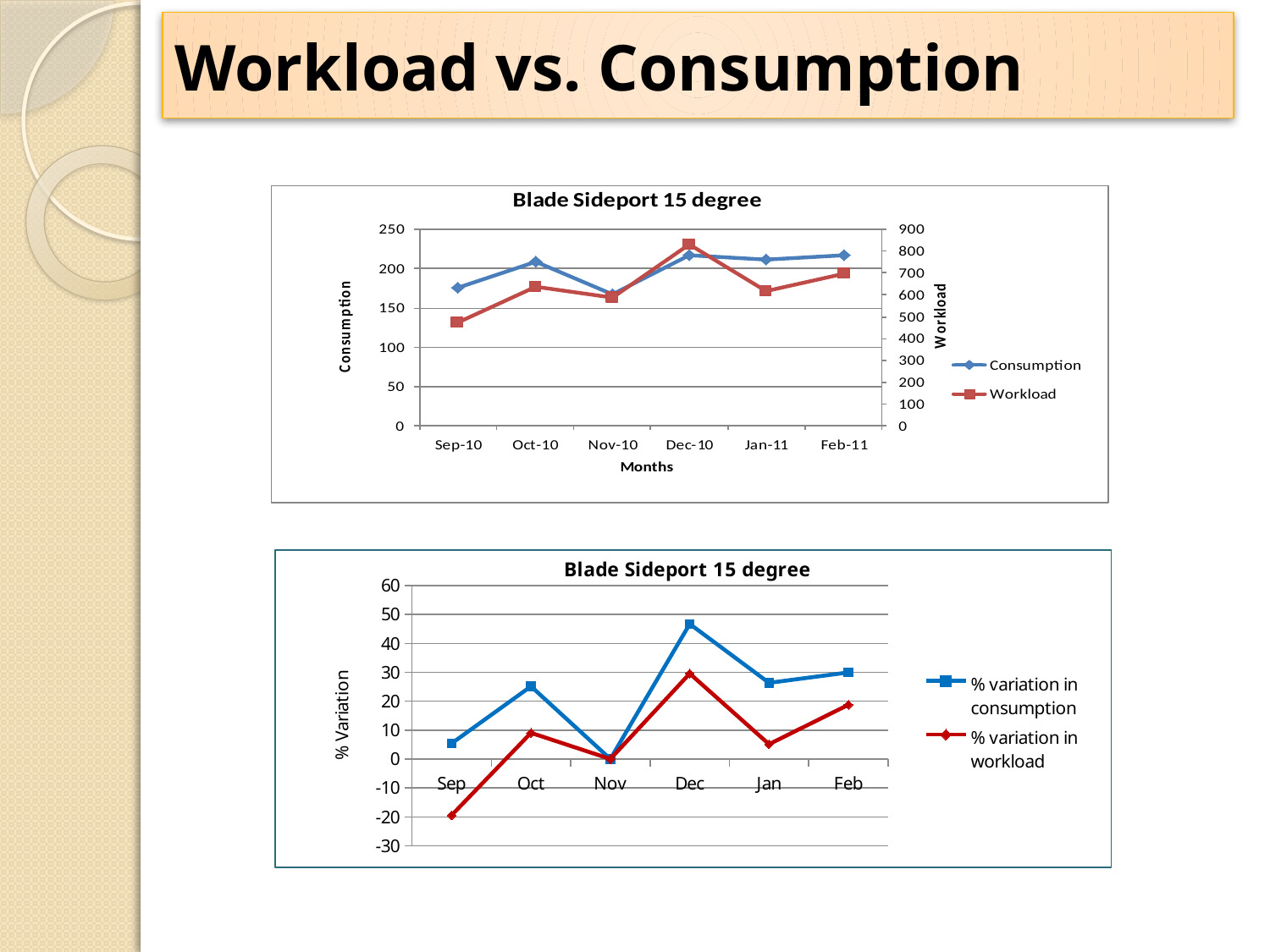
What kind of chart is the top chart on the slide? line chart How many series does the legend of the bottom chart list? 2 In the bottom chart, in which month is the % variation in workload lowest? Sep In the bottom chart, in which month is the % variation in consumption highest? Dec In the top chart, is the Workload value for Dec-10 greater or less than 800? greater How many series does the legend of the top chart list? 2 In the top chart, in which month is Workload lowest? Sep-10 In the top chart, is the Consumption value for Sep-10 greater or less than 200? less In the top chart, which axis title appears on the right-hand vertical axis? Workload How many months are plotted along the x axis of the top chart? 6 In the top chart, in which month does Workload reach its highest value? Dec-10 In the bottom chart, which is larger in Dec: the % variation in consumption or the % variation in workload? % variation in consumption